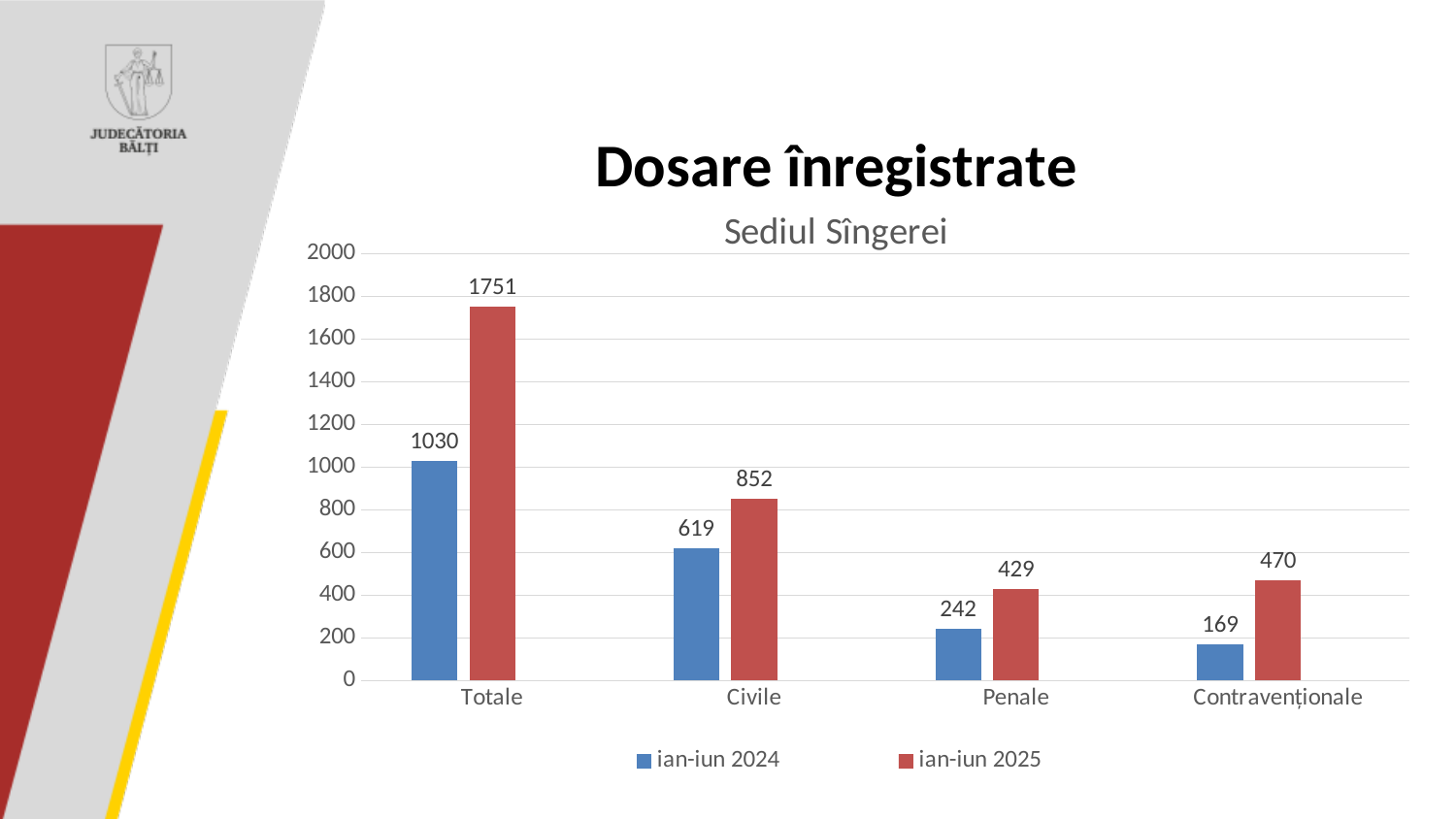
What is the difference between the ian-iun 2025 and ian-iun 2024 values for Totale? 721 How many categories are shown on the x axis? 4 What is the value for Civile in the ian-iun 2024 series? 619 What is the value for Contravenționale in the ian-iun 2024 series? 169 How many series does the legend list? 2 What is the value for Penale in the ian-iun 2025 series? 429 What is the difference between the ian-iun 2025 and ian-iun 2024 values for Civile? 233 Which category has the lowest value in the ian-iun 2024 series? Contravenționale Which category has the highest value in the ian-iun 2025 series? Totale What is the value for Totale in the ian-iun 2025 series? 1751 Which is larger: the ian-iun 2025 value for Penale or the ian-iun 2025 value for Contravenționale? Contravenționale What kind of chart is shown on the slide? Bar chart